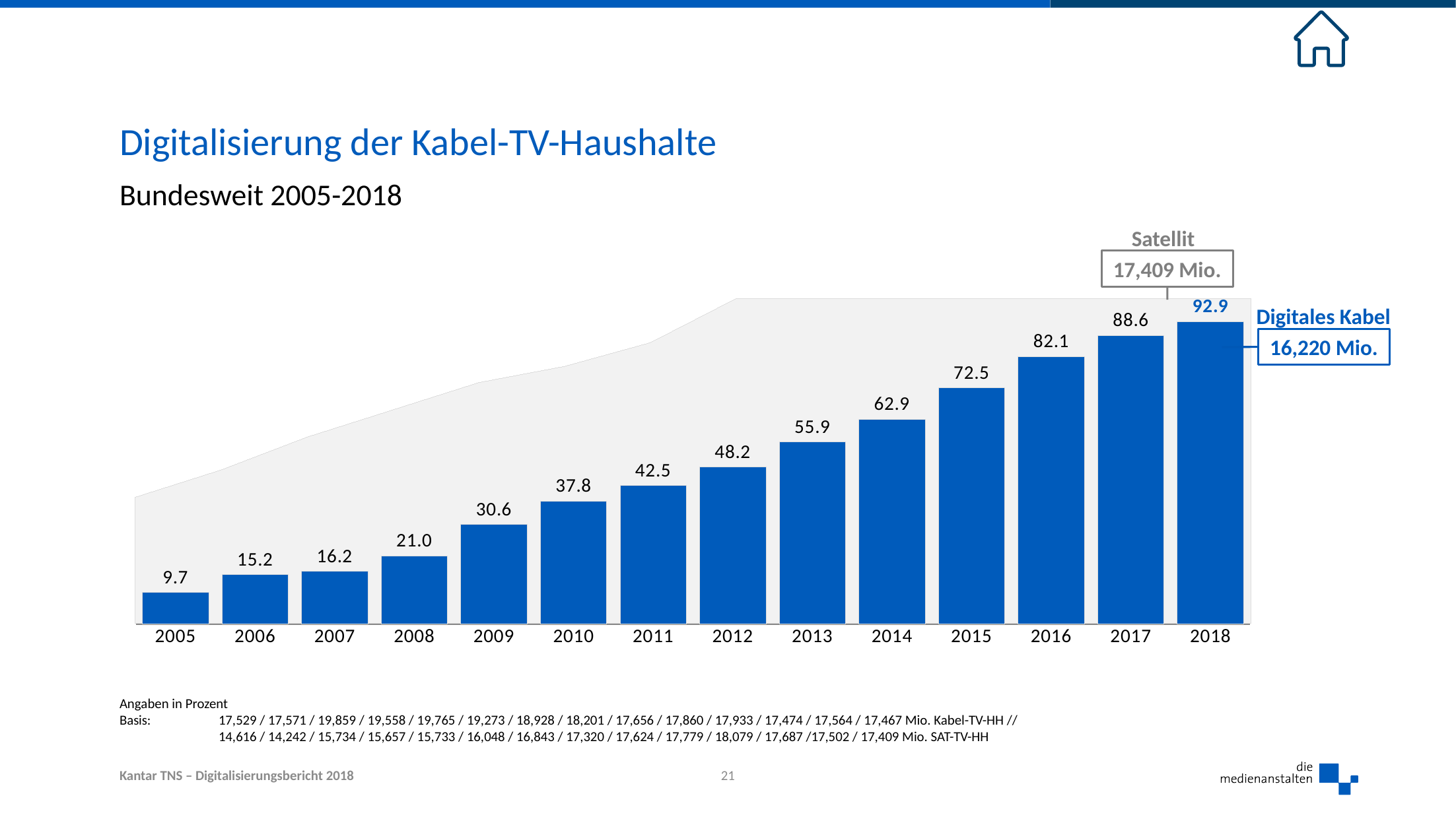
Which is larger, the value for 2009 or the value for 2010? 2010 What is the difference between the values for 2018 and 2017? 4.3 Which year has the highest value? 2018 What is the value for 2012? 48.2 Which year has the lowest value? 2005 What is the title of the chart? Digitalisierung der Kabel-TV-Haushalte How many years are shown on the x axis? 14 What is the difference between the values for 2015 and 2014? 9.6 What is the value for 2005? 9.7 What is the value for 2018? 92.9 What kind of chart is this? bar chart Do the values rise or fall from 2005 to 2018? rise